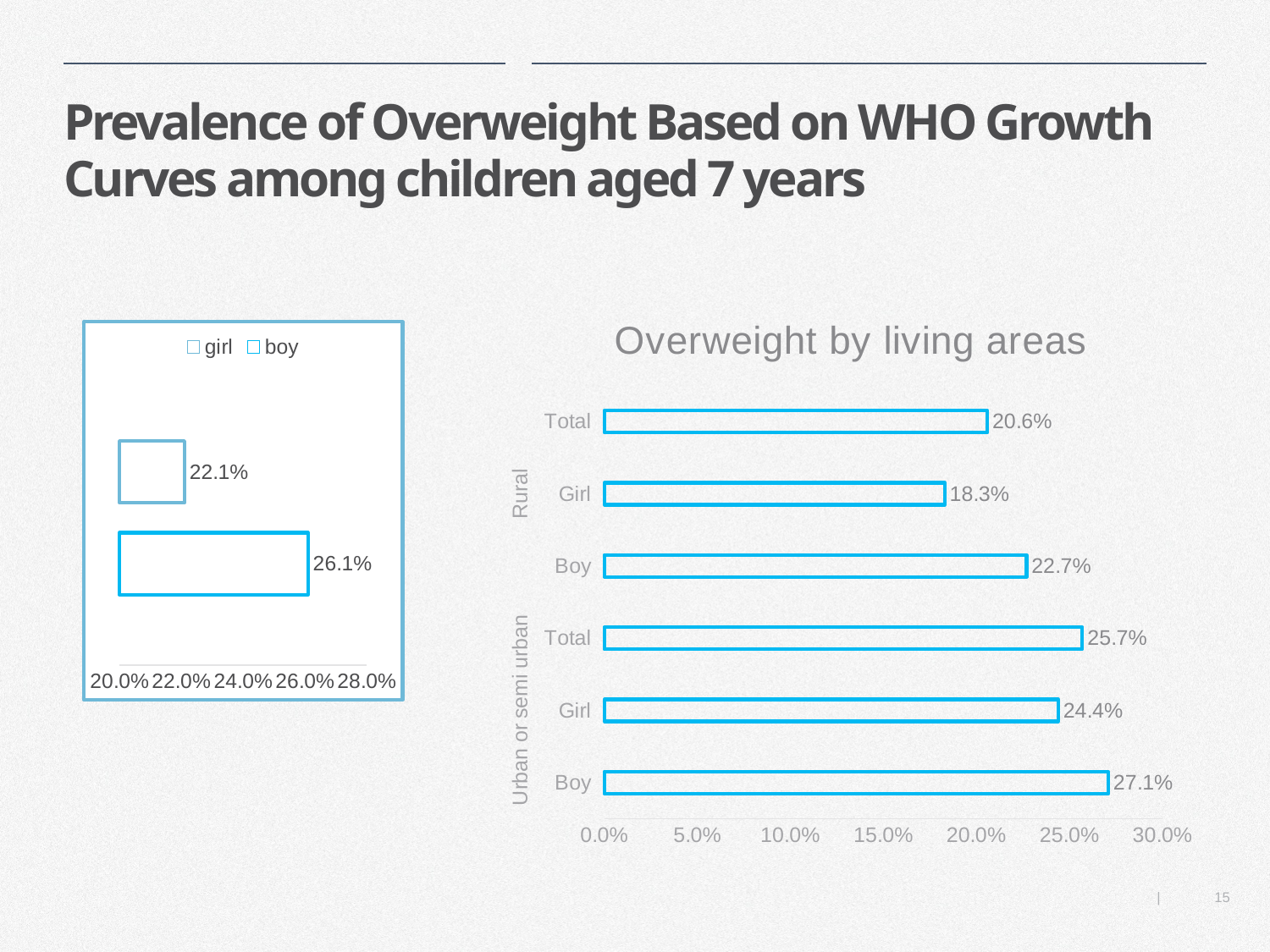
In the left chart, what is the value for boy? 26.1% In the left chart, what is the value for girl? 22.1% In the 'Overweight by living areas' chart, what is the value for Rural Girl? 18.3% In the 'Overweight by living areas' chart, which is larger: Rural Boy or Urban or semi urban Girl? Urban or semi urban Girl In the 'Overweight by living areas' chart, which category has the highest value? Urban or semi urban Boy In the left chart, what is the difference between the boy and girl values? 4.0% In the left chart, how many series does the legend list? 2 In the 'Overweight by living areas' chart, which category has the lowest value? Rural Girl In the 'Overweight by living areas' chart, what is the value for Rural Total? 20.6% In the 'Overweight by living areas' chart, how many bars are plotted? 6 In the 'Overweight by living areas' chart, what is the difference between the Urban or semi urban Total and the Rural Total? 5.1% In the 'Overweight by living areas' chart, what is the value for Urban or semi urban Boy? 27.1%